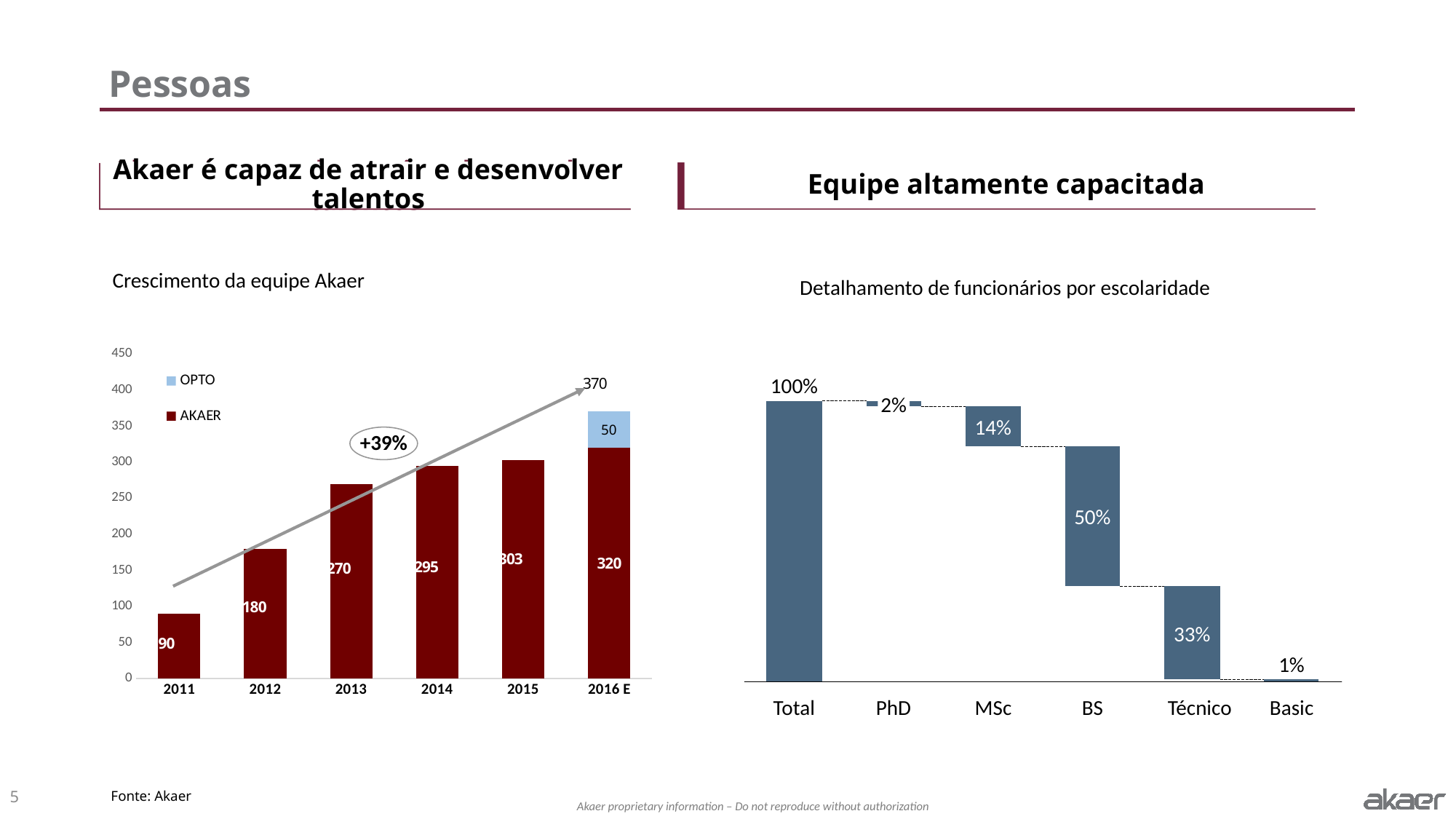
In the 'Crescimento da equipe Akaer' chart, which year has the lowest AKAER value? 2011 In the 'Crescimento da equipe Akaer' chart, how many years are shown on the x axis? 6 In the 'Crescimento da equipe Akaer' chart, what is the AKAER value for 2013? 270 In the 'Crescimento da equipe Akaer' chart, what is the OPTO value for 2016 E? 50 In the 'Crescimento da equipe Akaer' chart, what is the total of the stacked bar for 2016 E? 370 In the 'Detalhamento de funcionários por escolaridade' chart, which education level (excluding Total) has the smallest share? Basic In the 'Detalhamento de funcionários por escolaridade' chart, which is larger, MSc or Técnico? Técnico In the 'Detalhamento de funcionários por escolaridade' chart, what is the value for BS? 50% In the 'Detalhamento de funcionários por escolaridade' chart, what is the difference between the BS and Técnico values? 17% In the 'Crescimento da equipe Akaer' chart, what is the difference between the AKAER values for 2012 and 2011? 90 In the 'Crescimento da equipe Akaer' chart, do the AKAER values rise or fall from 2011 to 2016 E? rise In the 'Crescimento da equipe Akaer' chart, how many series does the legend list? 2